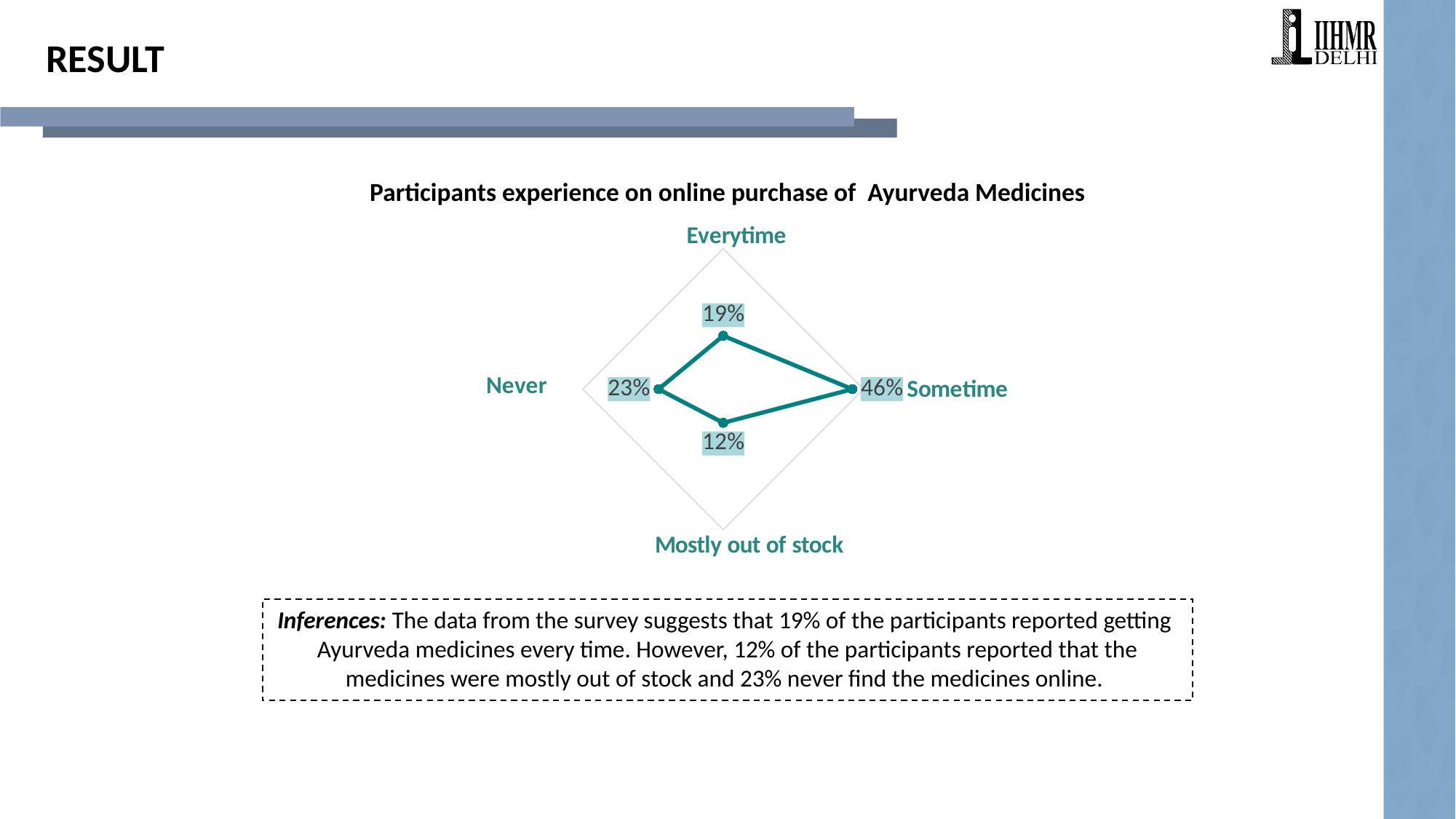
What is the value for the 'Never' category? 23% Which category has the lowest value? Mostly out of stock What percentage of participants reported getting Ayurveda medicines online every time? 19% What is the difference between the 'Everytime' and 'Mostly out of stock' values? 7% Which is larger, the value for 'Never' or the value for 'Everytime'? Never What is the title of the chart? Participants experience on online purchase of Ayurveda Medicines Which category has the highest value? Sometime What kind of chart is shown on the slide? Radar chart How many categories are plotted on the chart? 4 What is the value for 'Mostly out of stock'? 12% What is the value for the 'Sometime' category? 46% What is the difference between the 'Sometime' and 'Never' values? 23%